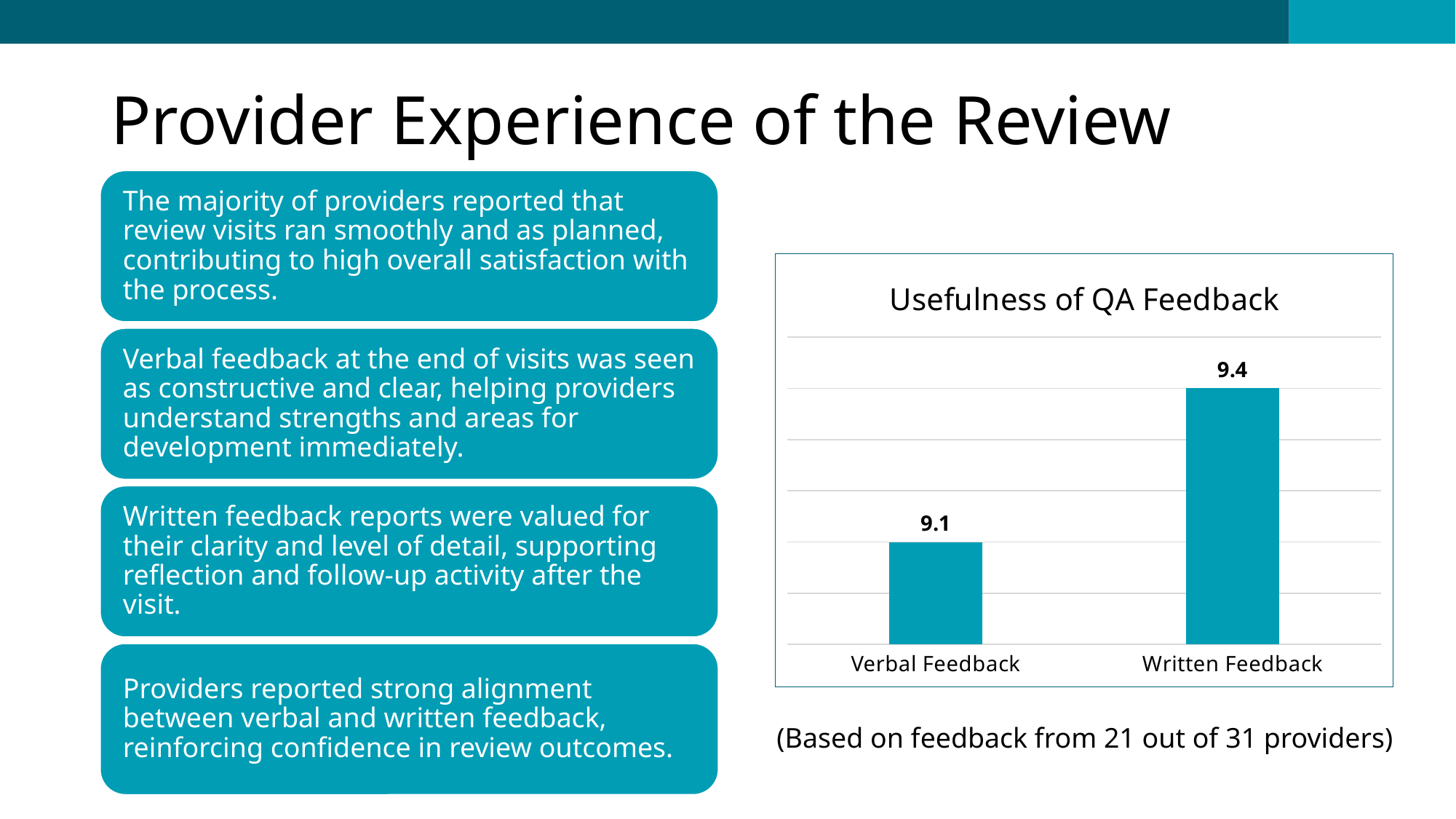
What is the value for Written Feedback? 9.4 What kind of chart is shown on the slide? Bar chart What colour are the bars in the chart? Teal What is the value for Verbal Feedback? 9.1 Which category has the lowest value? Verbal Feedback How many categories are shown in the chart? 2 What is the difference between the values for Written Feedback and Verbal Feedback? 0.3 Which category has the highest value? Written Feedback What is the title of the chart? Usefulness of QA Feedback Which is larger, the value for Verbal Feedback or the value for Written Feedback? Written Feedback Do the values rise or fall from Verbal Feedback to Written Feedback? Rise